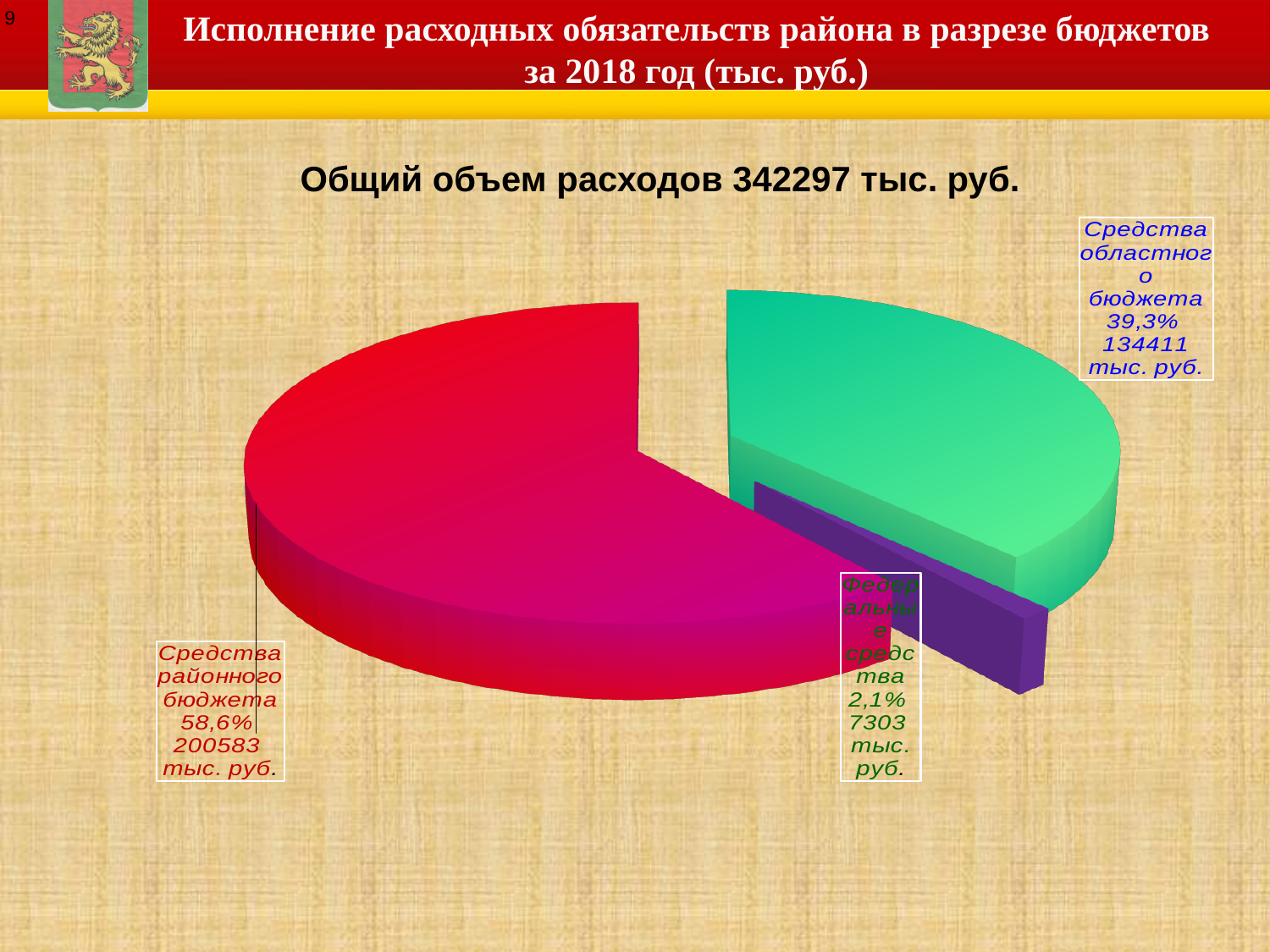
Which is larger, Средства областного бюджета or Федеральные средства? Средства областного бюджета What share of the pie does Средства областного бюджета represent? 39,3% What is the value for Федеральные средства? 7303 тыс. руб. What share of the pie does Федеральные средства represent? 2,1% What is the value for Средства областного бюджета? 134411 тыс. руб. What kind of chart is shown on the slide? Pie chart Which slice is the largest? Средства районного бюджета Which slice is the smallest? Федеральные средства What is the value for Средства районного бюджета? 200583 тыс. руб. What is the difference between Средства районного бюджета and Средства областного бюджета? 66172 тыс. руб. How many slices does the pie chart have? 3 What total expenditure volume is stated above the chart? 342297 тыс. руб.